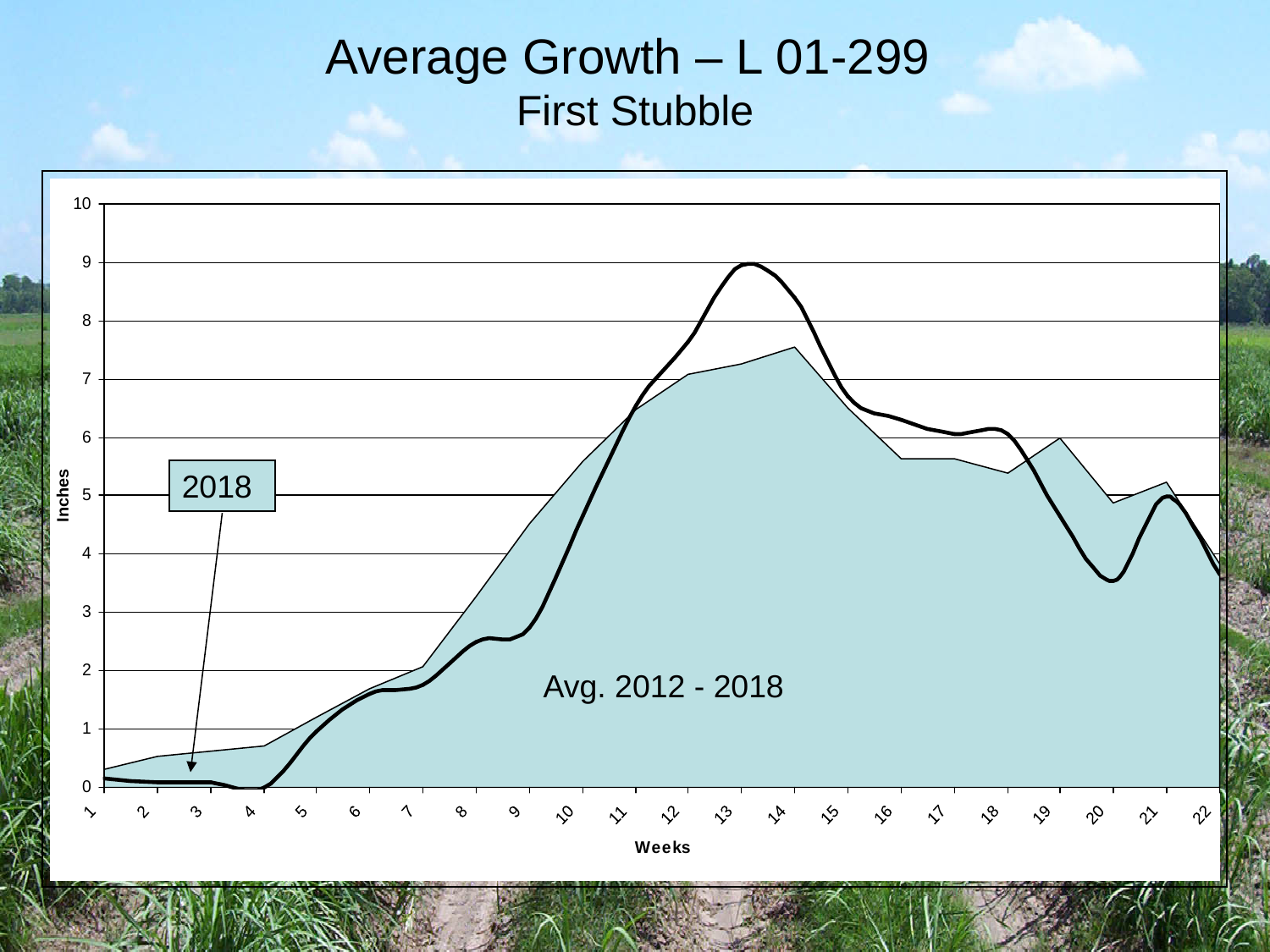
Is the 2018 series drawn as a line or as bars? line At which week does the 2018 line reach its highest value? 13 What is the label on the vertical axis of the chart? Inches At week 13, which is higher: the 2018 line or the Avg. 2012 - 2018 series? 2018 Does the 2018 line rise or fall between week 14 and week 20? fall What is the title of the chart on the slide? Average Growth – L 01-299 First Stubble Is the 2018 value at week 20 greater or less than 4? less How many weeks are plotted along the x axis? 22 How many data series are shown on the chart? 2 Is the 2018 value at week 13 greater or less than 8? greater At which week does the Avg. 2012 - 2018 series reach its highest value? 14 Is the Avg. 2012 - 2018 value at week 19 greater or less than 5? greater